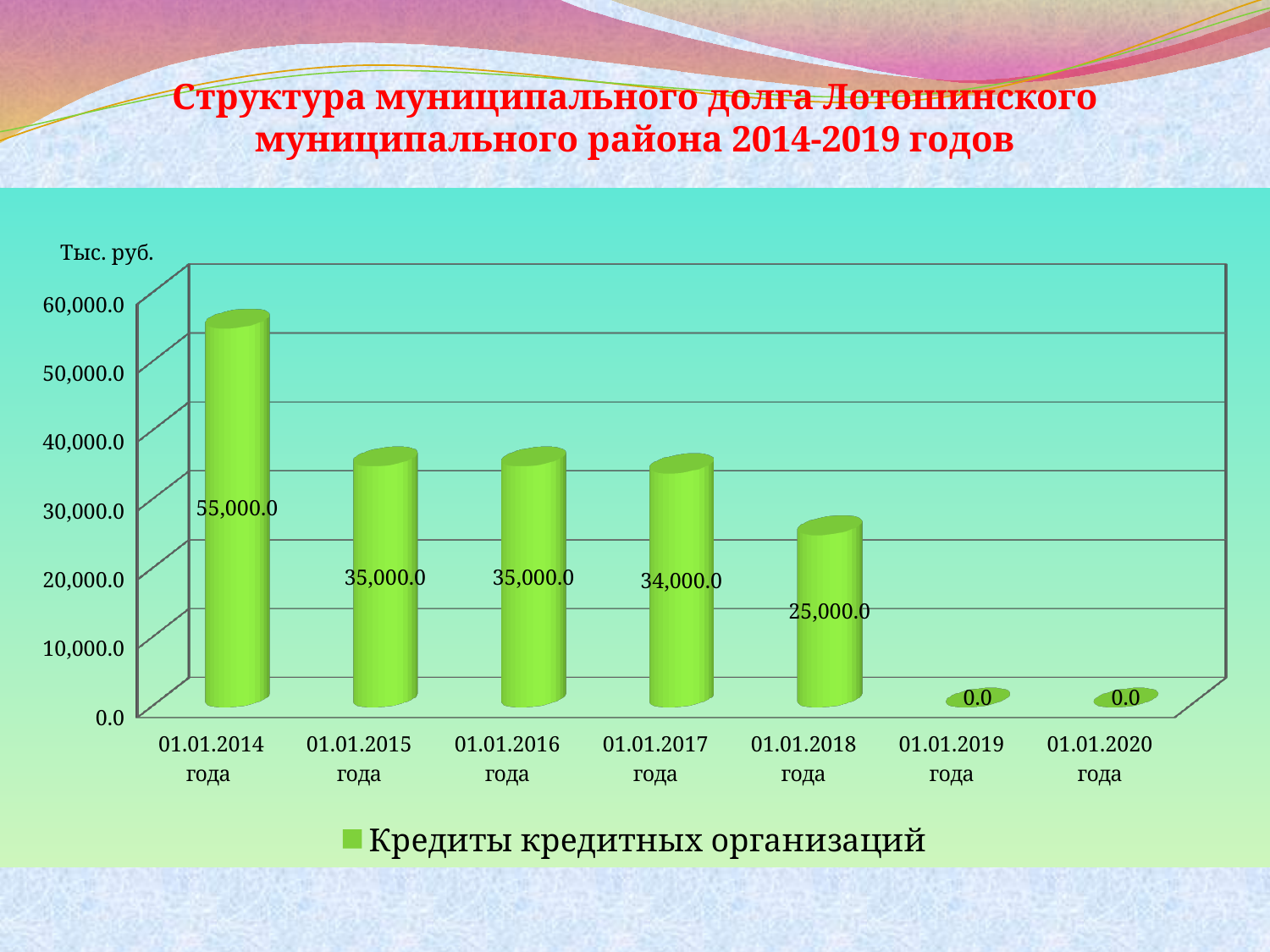
How many dates are shown on the x axis? 7 What is the difference between the values for 01.01.2017 года and 01.01.2018 года? 9,000.0 What is the value for 01.01.2018 года? 25,000.0 Which date has the highest value? 01.01.2014 года Which is larger, the value for 01.01.2016 года or the value for 01.01.2017 года? 01.01.2016 года Do the values rise or fall from 01.01.2014 года to 01.01.2020 года? fall How many series does the legend list? 1 What kind of chart is shown? bar chart Is the value for 01.01.2018 года greater or less than 30,000.0? less What is the value for 01.01.2017 года? 34,000.0 What is the value for 01.01.2014 года? 55,000.0 What is the difference between the values for 01.01.2014 года and 01.01.2015 года? 20,000.0